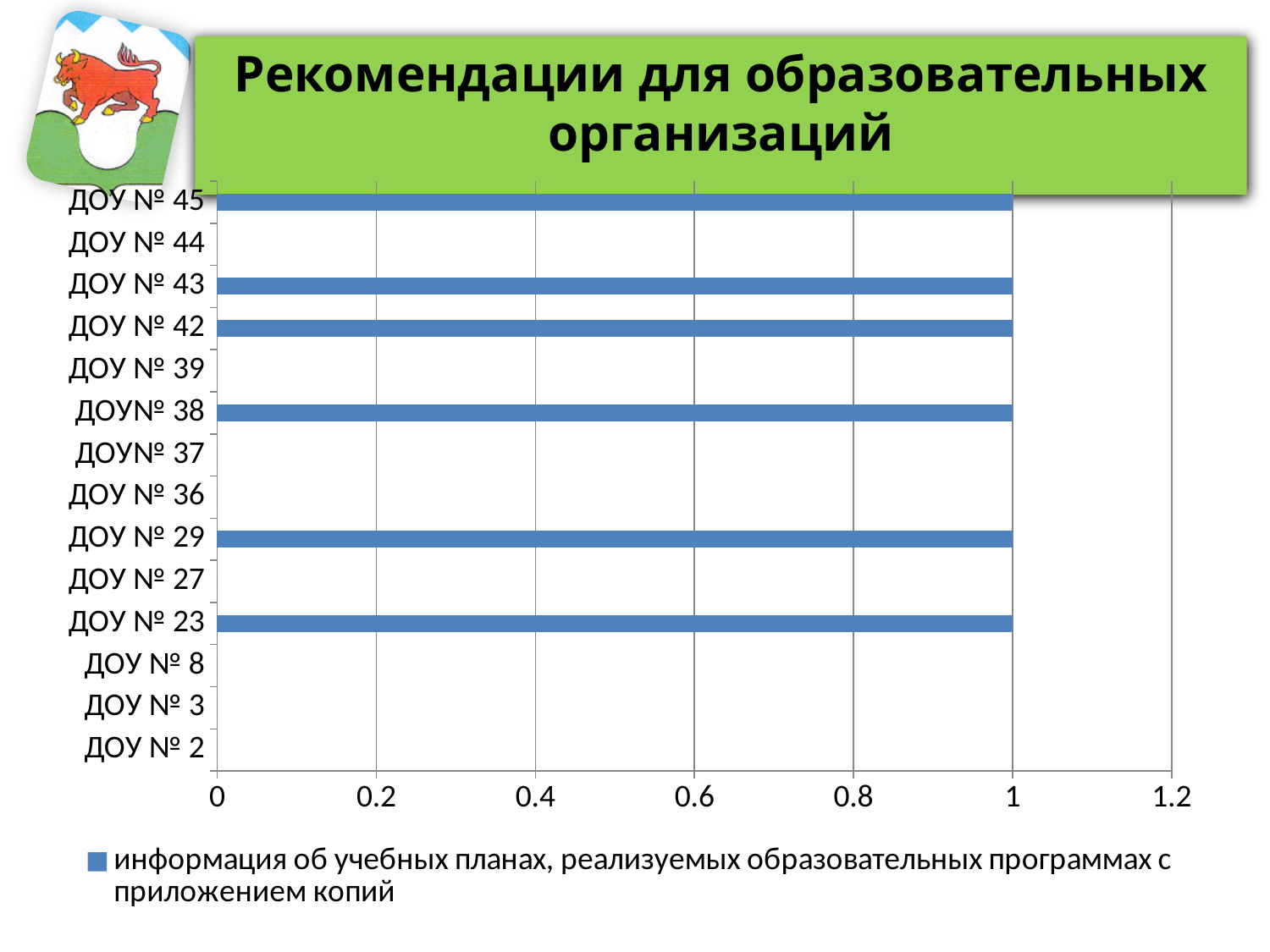
What is the highest value shown on the horizontal axis of the chart? 1.2 What kind of chart is shown on the slide? bar chart How many categories (ДОУ) are listed on the vertical axis of the chart? 14 Is the value for ДОУ № 44 greater or less than 0.2? less Which is larger, the value for ДОУ № 43 or the value for ДОУ № 39? ДОУ № 43 What is the value for ДОУ № 23 in the chart? 1 How many series does the chart legend list? 1 What is the value for ДОУ № 45 in the chart? 1 Is the value for ДОУ № 42 greater or less than 0.8? greater How many categories in the chart have a visible bar? 6 Which is larger, the value for ДОУ № 38 or the value for ДОУ № 37? ДОУ № 38 What is the value for ДОУ № 29 in the chart? 1